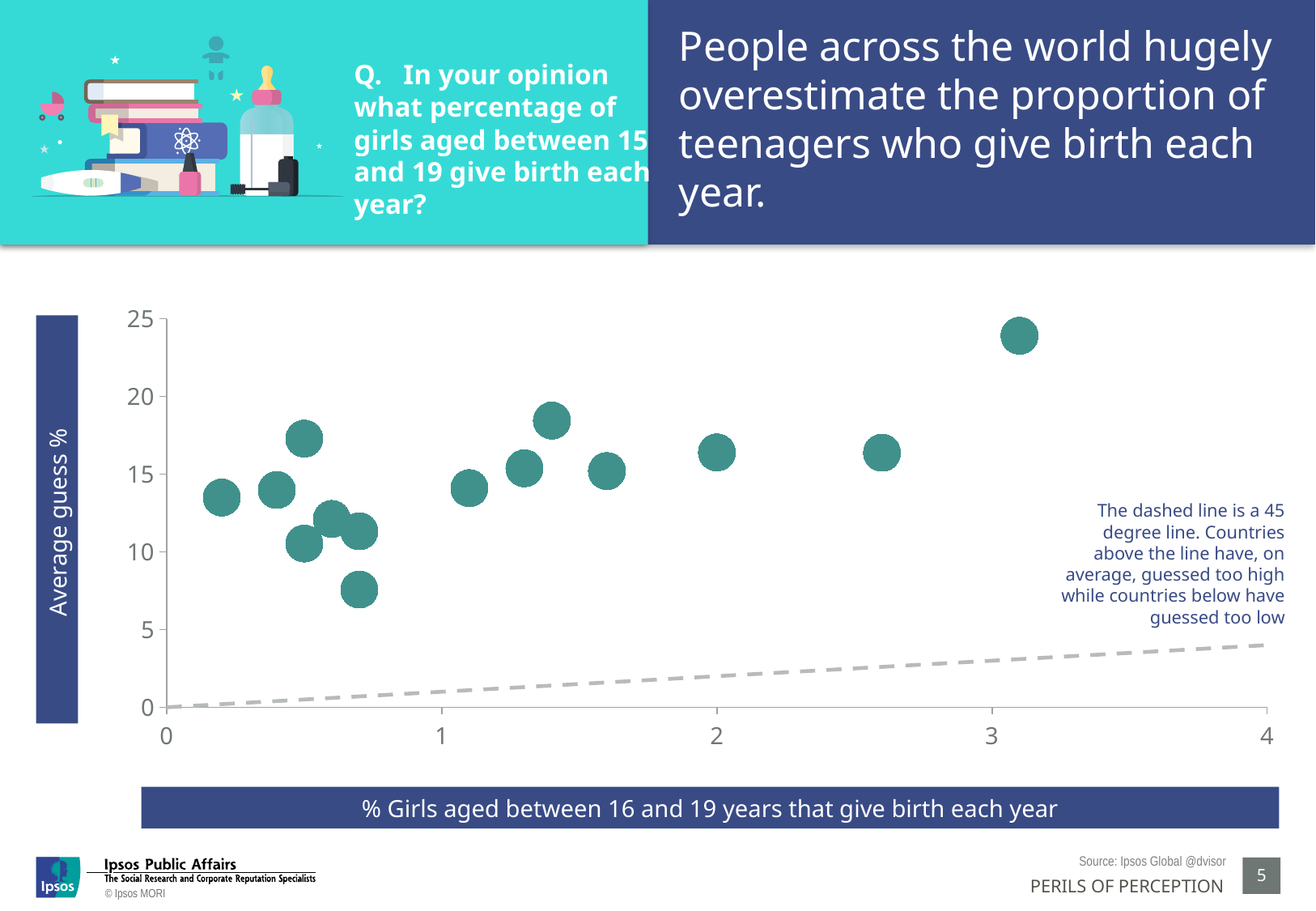
Does the point with the largest actual percentage (furthest right) also have the highest average guess? yes What is the highest value shown on the vertical axis? 25 Is the average guess for the point at an actual value of about 2 greater or less than 15? greater Is the average guess for the lowest point on the chart greater or less than 10? less Is the average guess for the point at an actual value of about 1.4 greater or less than 15? greater How many data points are plotted on the scatter chart? 14 What kind of chart is shown on the slide? scatter chart Are all the plotted points above or below the dashed 45 degree line? above What is the title of the horizontal axis of the chart? % Girls aged between 16 and 19 years that give birth each year What is the highest value shown on the horizontal axis? 4 What is the title of the vertical axis of the chart? Average guess %